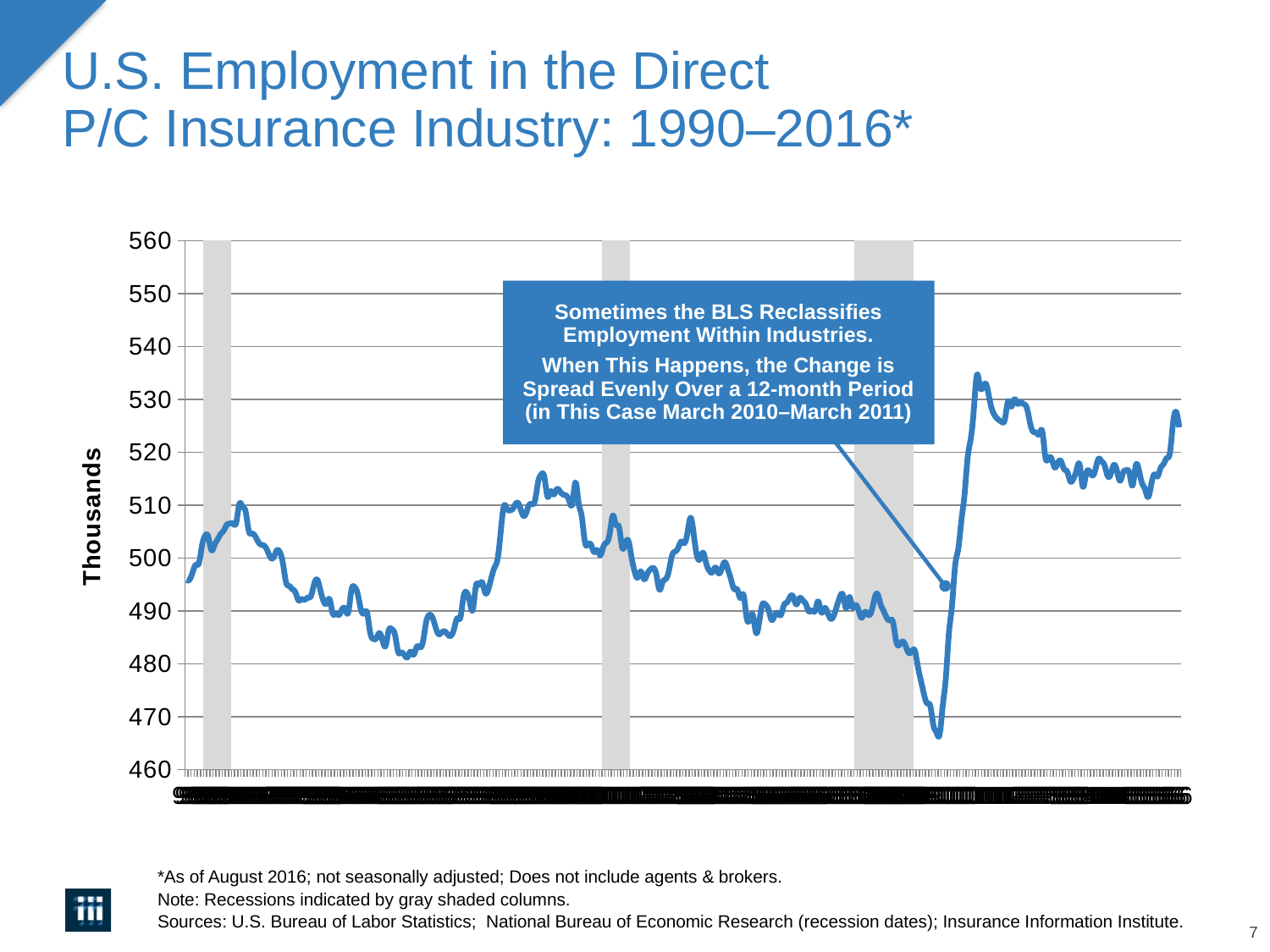
What is the title of the chart on the slide? U.S. Employment in the Direct P/C Insurance Industry: 1990–2016* Is the value at the right end of the line (August 2016) greater or less than 520? greater Is the highest point of the line on the chart greater or less than 520? greater What kind of chart is shown on the slide? line chart Is the value at the point marked by the callout (the end of the reclassification period) greater or less than 500? less How many gray shaded recession columns appear on the chart? 3 What is the label on the vertical axis of the chart? Thousands Is the value at the right end of the line higher or lower than the value at the left end of the line? higher What is the highest value shown on the vertical axis of the chart? 560